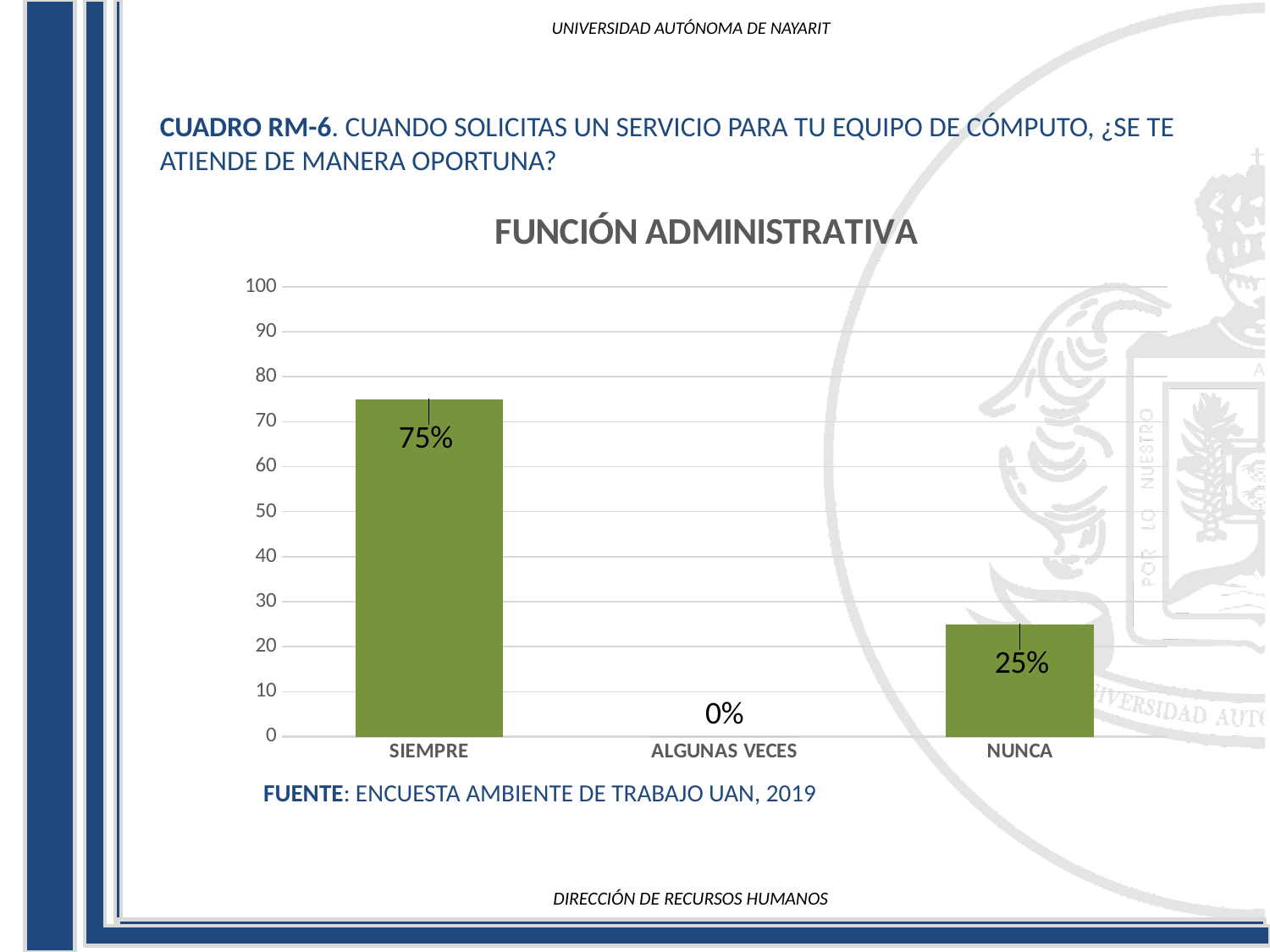
What is the value for SIEMPRE? 75% Is the value for NUNCA greater or less than 30? less What is the value for NUNCA? 25% Which category has the lowest value? ALGUNAS VECES What is the value for ALGUNAS VECES? 0% What kind of chart is shown on the slide? bar chart Is the value for SIEMPRE greater or less than 50? greater Which is larger, the value for SIEMPRE or the value for NUNCA? SIEMPRE What is the difference between the values for SIEMPRE and NUNCA? 50% Which category has the highest value? SIEMPRE How many categories are shown on the x axis? 3 What is the title of the chart? FUNCIÓN ADMINISTRATIVA